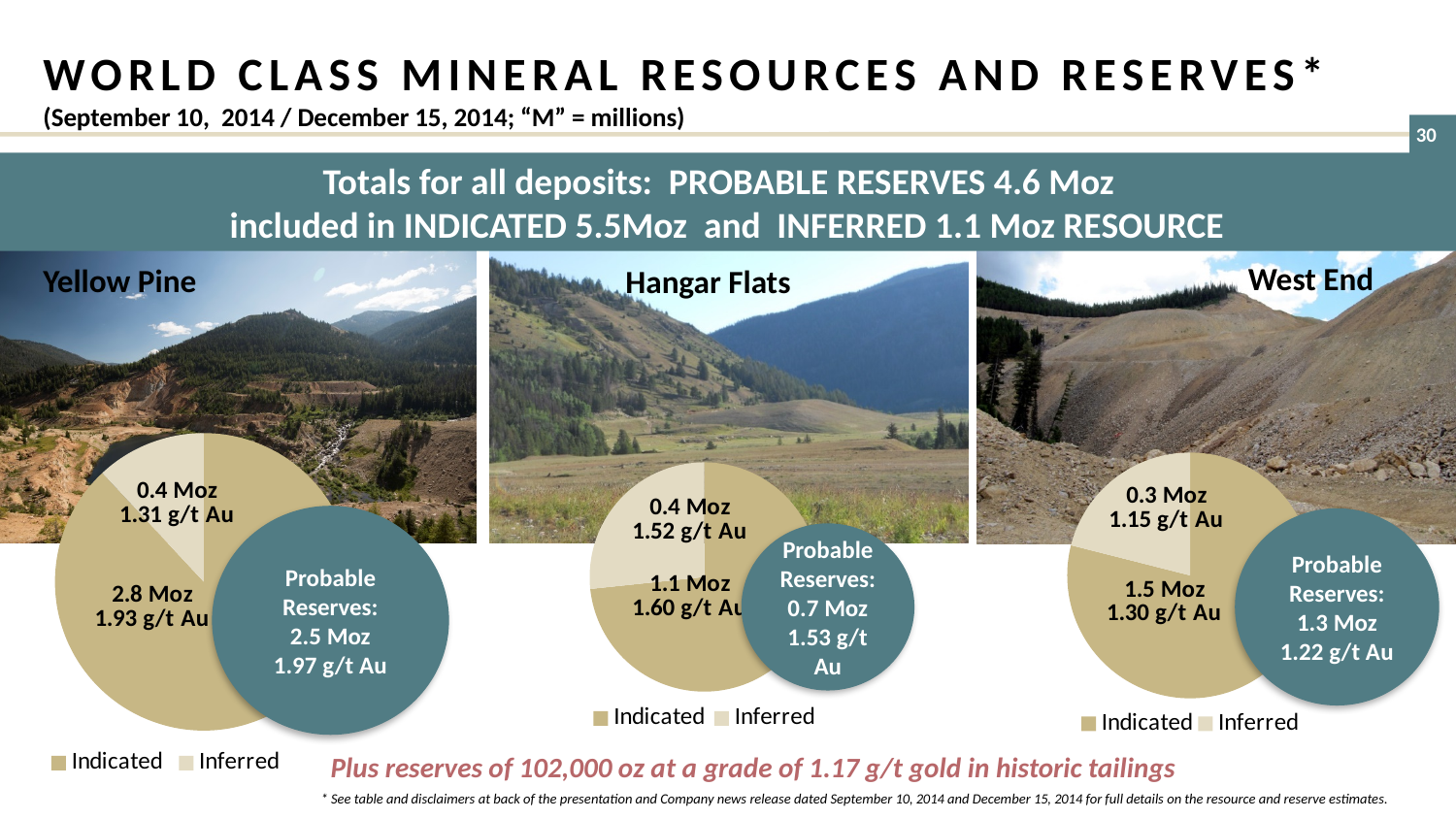
How many slices does the Hangar Flats pie chart have? 2 In the Yellow Pine pie chart, what is the difference in Moz between the Indicated and Inferred slices? 2.4 Moz What two categories does the legend of the West End pie chart list? Indicated and Inferred In the Hangar Flats pie chart, what is the Inferred resource value? 0.4 Moz In the West End pie chart, what is the Indicated resource value? 1.5 Moz In the Yellow Pine pie chart, which slice is larger, Indicated or Inferred? Indicated In the West End pie chart, what is the difference in Moz between the Indicated and Inferred slices? 1.2 Moz In the Hangar Flats pie chart, what grade is shown for the Indicated slice? 1.60 g/t Au What type of chart is used for the Yellow Pine deposit? Pie chart In the Yellow Pine pie chart, what is the Indicated resource value? 2.8 Moz In the West End pie chart, what is the Inferred resource value? 0.3 Moz In the Yellow Pine pie chart, what grade is shown for the Inferred slice? 1.31 g/t Au